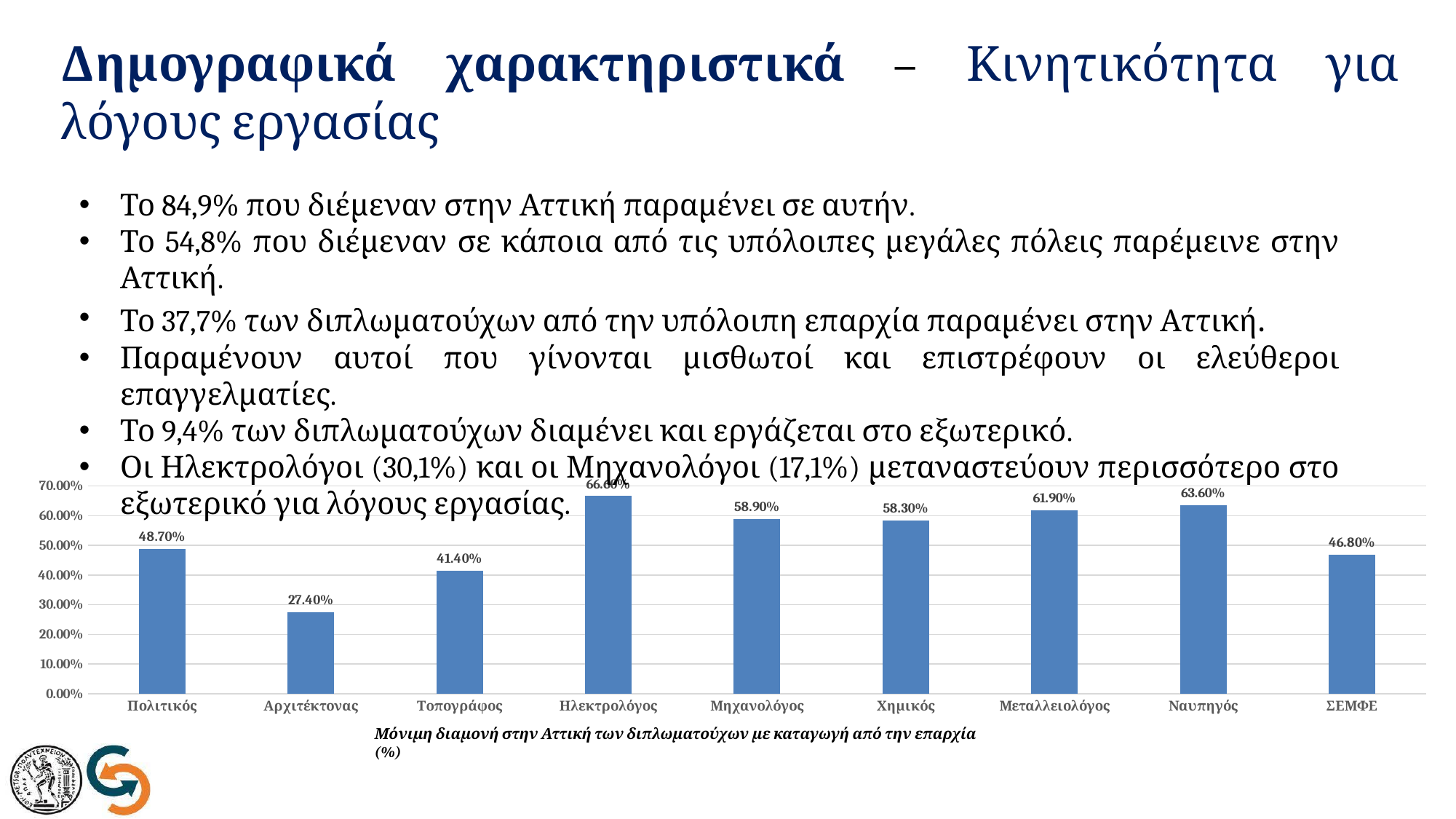
Is the value for Ηλεκτρολόγος greater or less than 60.00%? greater What is the title of the chart? Μόνιμη διαμονή στην Αττική των διπλωματούχων με καταγωγή από την επαρχία (%) What type of chart is shown on the slide? Bar chart What is the value for Πολιτικός in the chart? 48.70% What is the value for Αρχιτέκτονας in the chart? 27.40% Which is larger, the value for Τοπογράφος or the value for ΣΕΜΦΕ? ΣΕΜΦΕ What is the value for ΣΕΜΦΕ in the chart? 46.80% How many categories (specialties) are shown on the x axis of the chart? 9 What is the value for Μεταλλειολόγος in the chart? 61.90% Which category has the highest value in the chart? Ηλεκτρολόγος Which category has the lowest value in the chart? Αρχιτέκτονας What is the difference between the values for Ναυπηγός and Μεταλλειολόγος? 1.70%